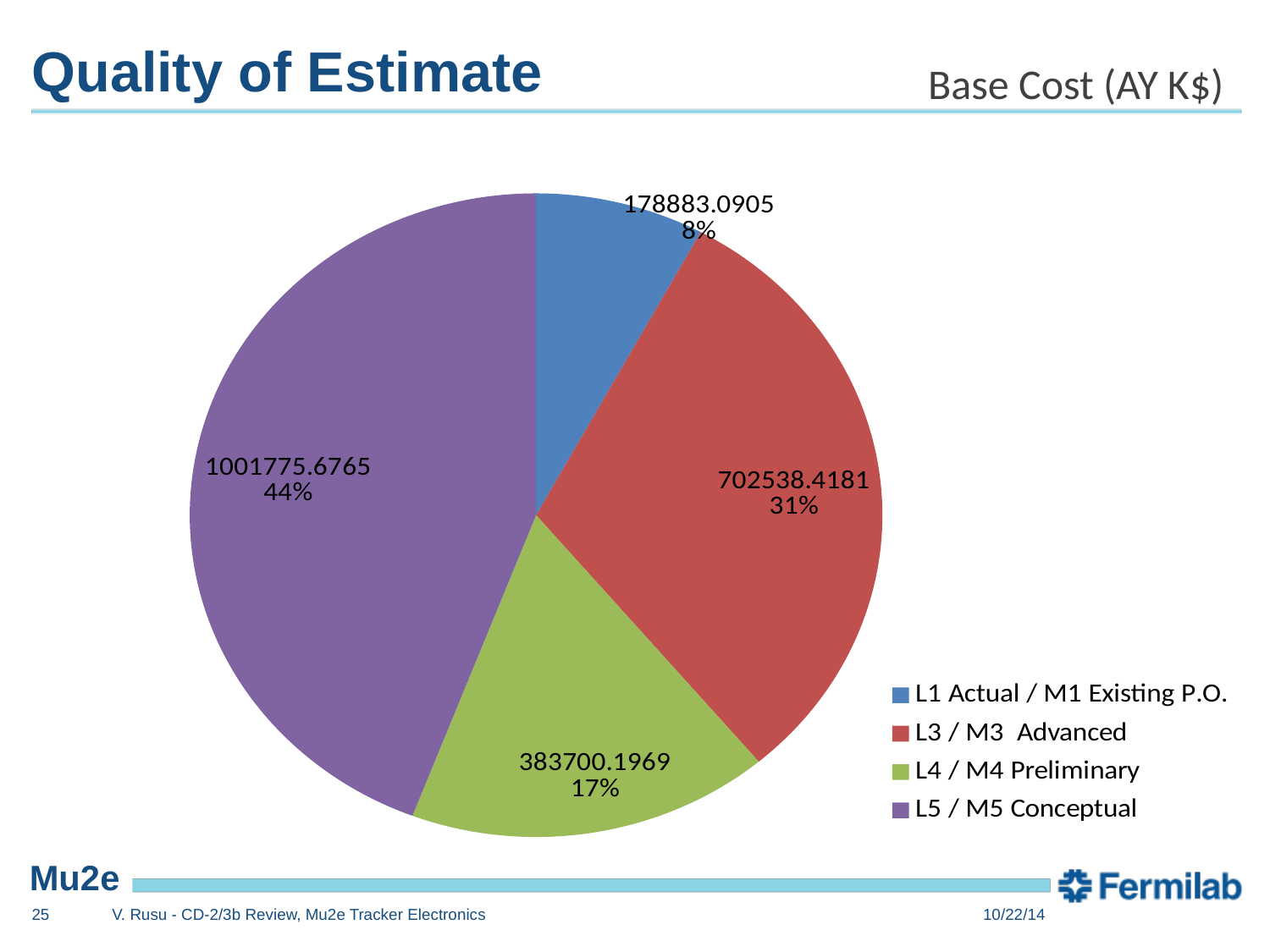
What share of the pie does L1 Actual / M1 Existing P.O. represent? 8% What is the difference between the values for L5 / M5 Conceptual and L3 / M3 Advanced? 299237.2584 What is the value for L4 / M4 Preliminary? 383700.1969 What is the value for L3 / M3 Advanced? 702538.4181 Which is larger, L3 / M3 Advanced or L4 / M4 Preliminary? L3 / M3 Advanced What is the value for L5 / M5 Conceptual? 1001775.6765 What kind of chart is shown on the slide? pie chart Which category has the smallest slice? L1 Actual / M1 Existing P.O. What is the value for L1 Actual / M1 Existing P.O.? 178883.0905 Which category has the largest slice? L5 / M5 Conceptual What share of the pie does L5 / M5 Conceptual represent? 44% How many categories does the legend list? 4